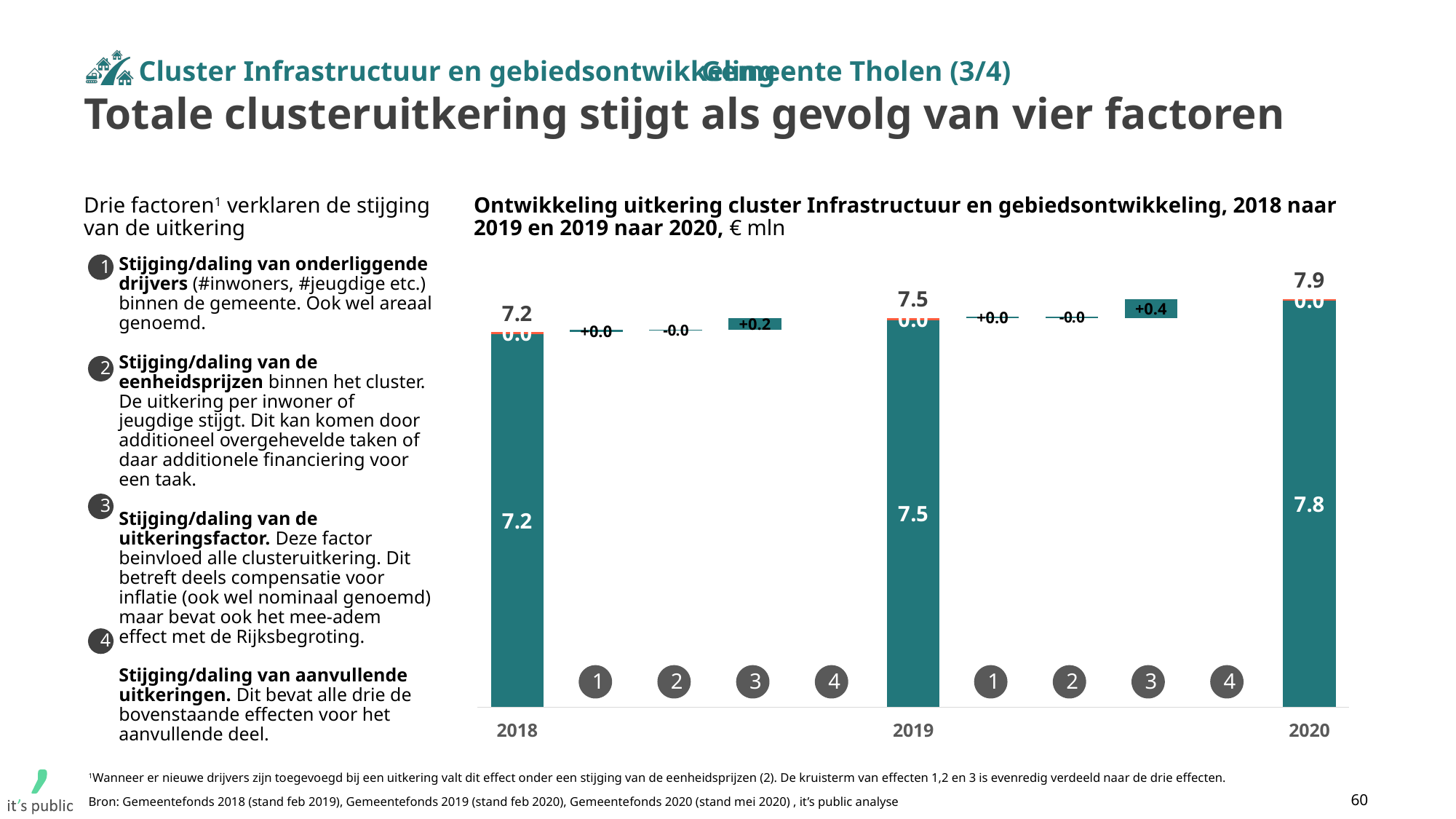
Which year has the highest total cluster payment? 2020 What is the value of factor 3 between 2018 and 2019? +0.2 What is the total cluster payment shown for 2019? 7.5 What is the total cluster payment shown for 2018? 7.2 Which year has the lowest total cluster payment? 2018 What is the value of factor 3 between 2019 and 2020? +0.4 What unit is the chart expressed in, according to its title? € mln What is the total cluster payment shown for 2020? 7.9 What is the value of factor 1 between 2019 and 2020? +0.0 What is the difference between the 2020 total and the 2018 total? 0.7 Do the total cluster payments rise or fall from 2018 to 2020? rise Which is larger: the factor 3 effect from 2018 to 2019 or from 2019 to 2020? 2019 to 2020